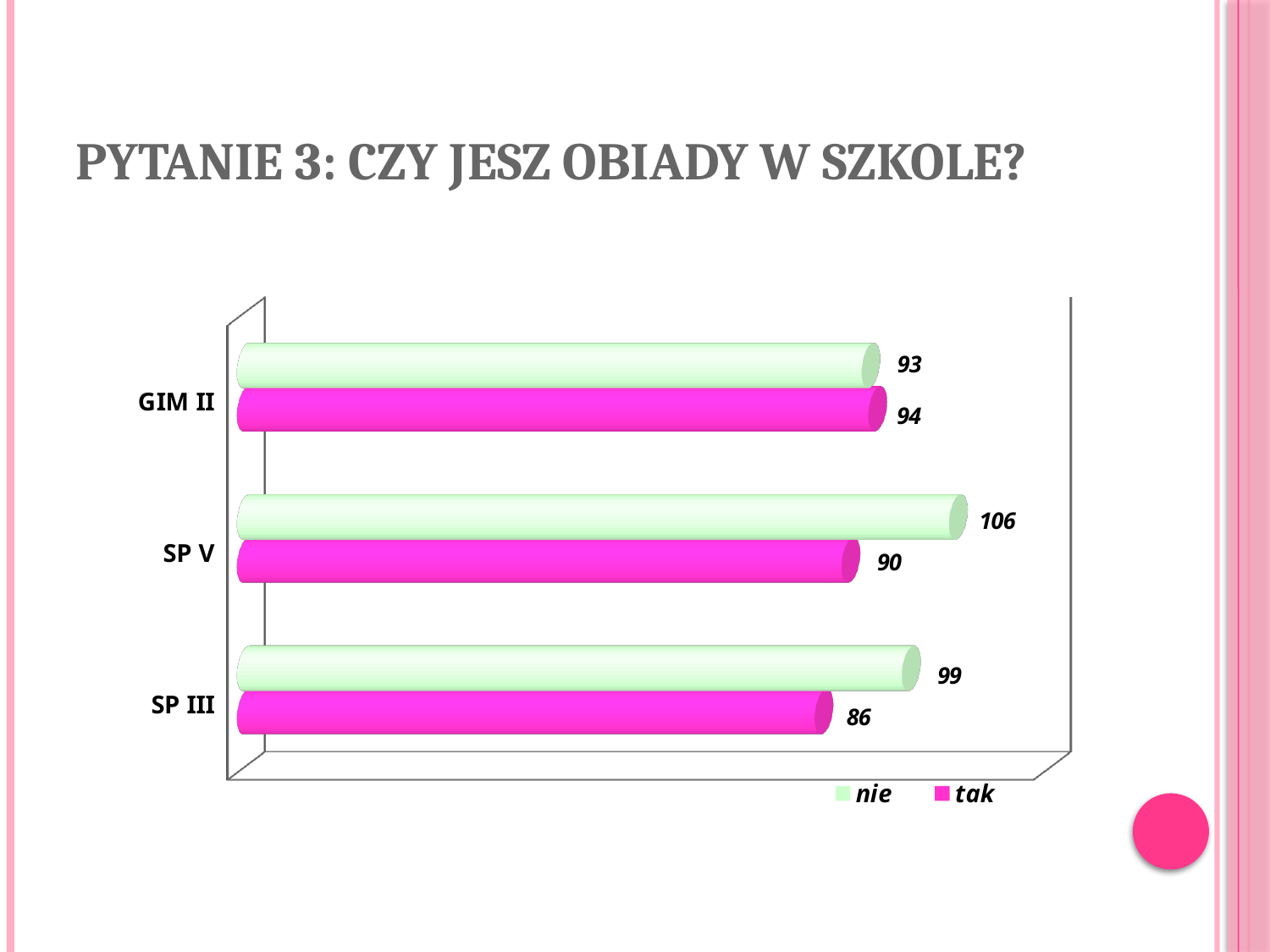
Which category has the lowest "tak" value? SP III What kind of chart is shown on the slide? bar chart Which category has the highest "nie" value? SP V What is the difference between the "nie" and "tak" values for SP V? 16 What is the value for "tak" for GIM II? 94 What is the difference between the "nie" and "tak" values for SP III? 13 What is the value for "nie" for SP III? 99 What is the value for "nie" for SP V? 106 How many series does the legend list? 2 For SP V, which is larger: "nie" or "tak"? nie How many categories are shown on the chart? 3 What is the value for "tak" for SP III? 86